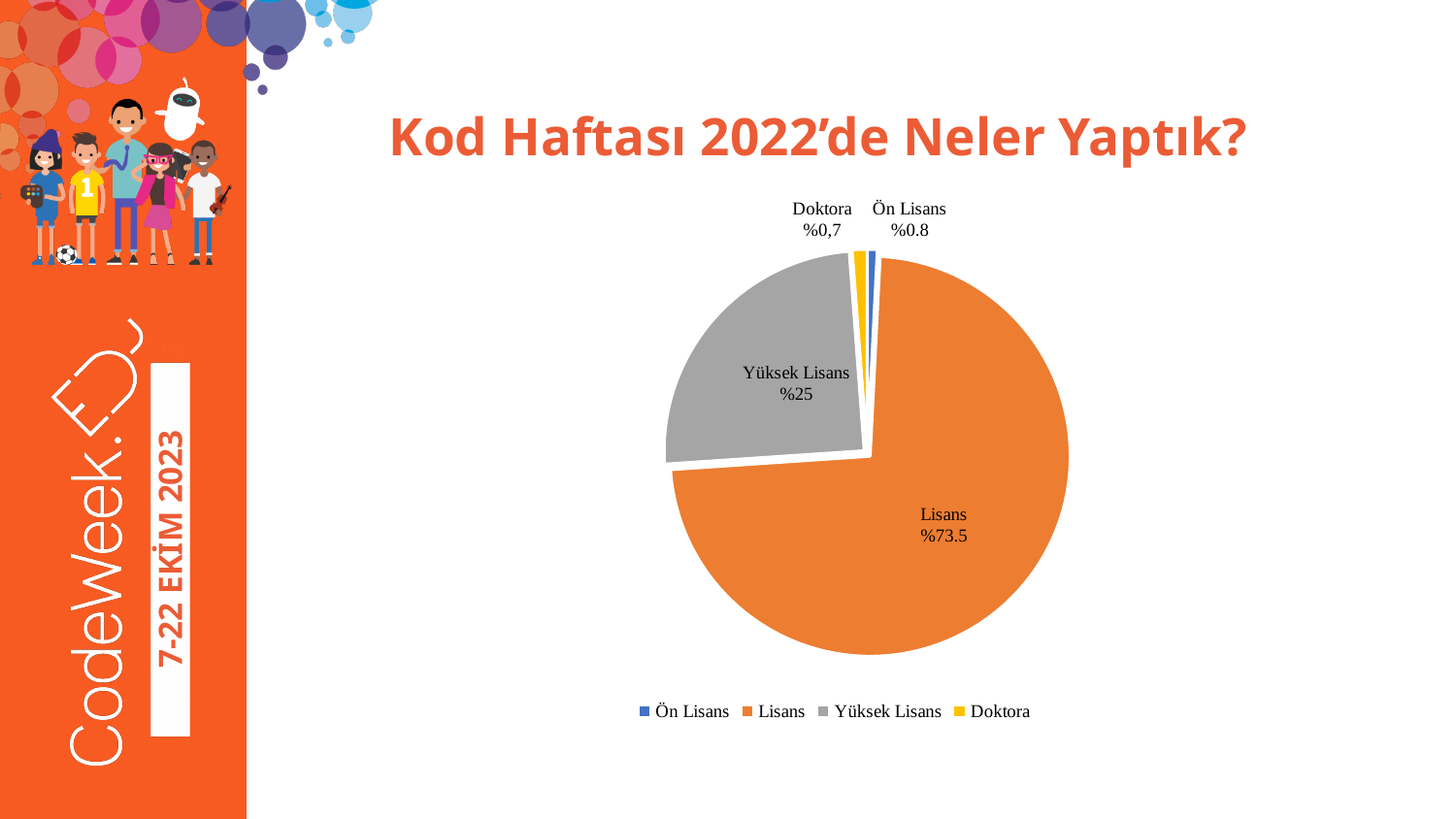
How many entries does the legend list? 4 Which is larger, the slice for Lisans or the slice for Yüksek Lisans? Lisans What value is shown for Doktora? %0,7 What share of the pie does Lisans have? %73.5 What kind of chart is shown on the slide? pie chart What share of the pie does Yüksek Lisans have? %25 How many slices does the pie chart have? 4 What is the difference between the Lisans share and the Yüksek Lisans share? %48.5 What colour is the Lisans slice in the pie chart? orange Which category has the largest slice of the pie? Lisans What value is shown for Ön Lisans? %0.8